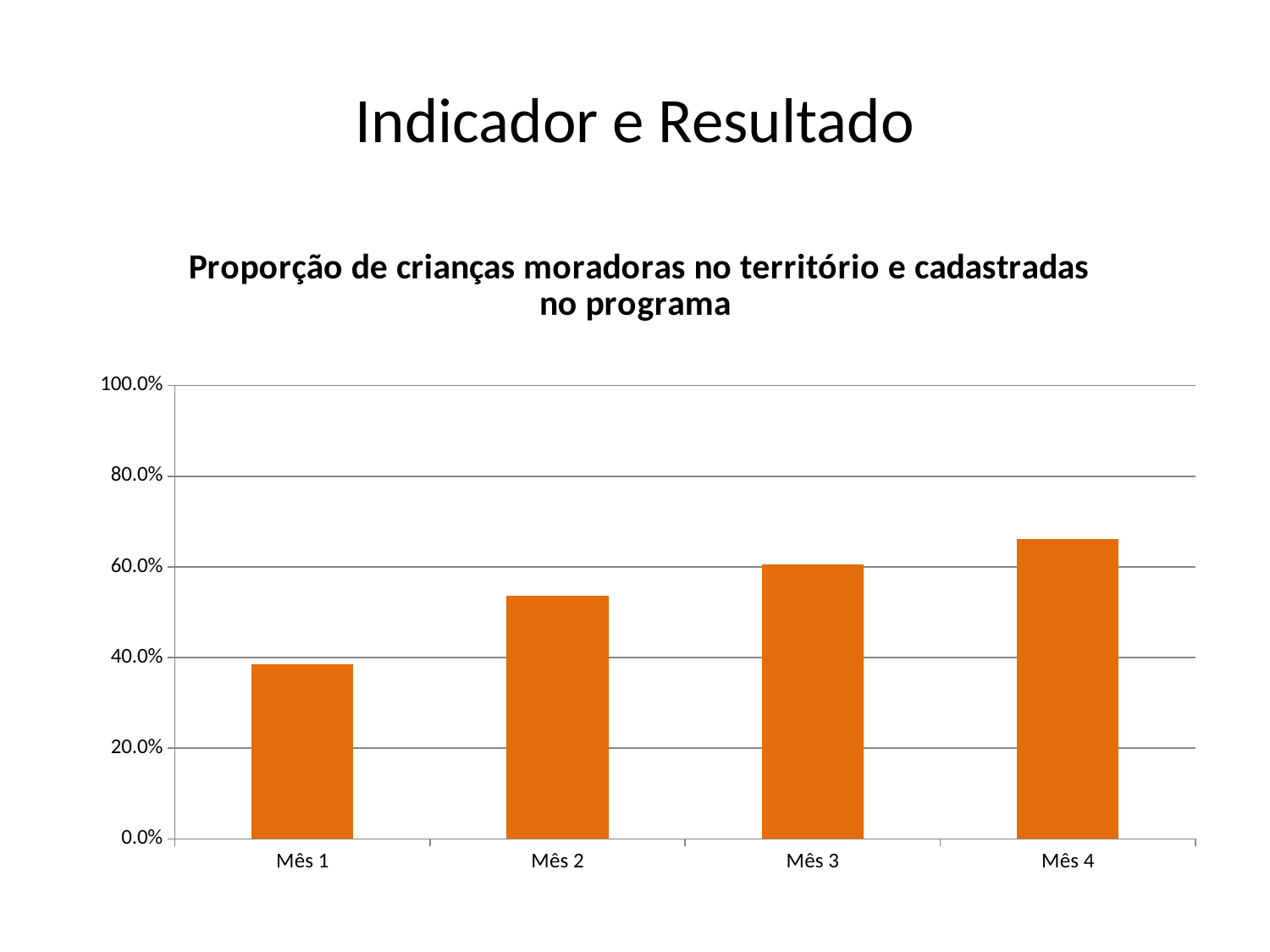
How many categories are shown on the x axis of the chart? 4 Is the value for Mês 4 greater or less than 60.0%? greater Which month has the lowest value in the chart? Mês 1 Is the value for Mês 2 greater or less than 60.0%? less Which month has the highest value in the chart? Mês 4 Which is larger, the value for Mês 4 or the value for Mês 2? Mês 4 Which is larger, the value for Mês 2 or the value for Mês 1? Mês 2 Do the values rise or fall from Mês 1 to Mês 4? rise What is the title of the chart? Proporção de crianças moradoras no território e cadastradas no programa What kind of chart is shown on the slide? bar chart Is the value for Mês 1 greater or less than 40.0%? less